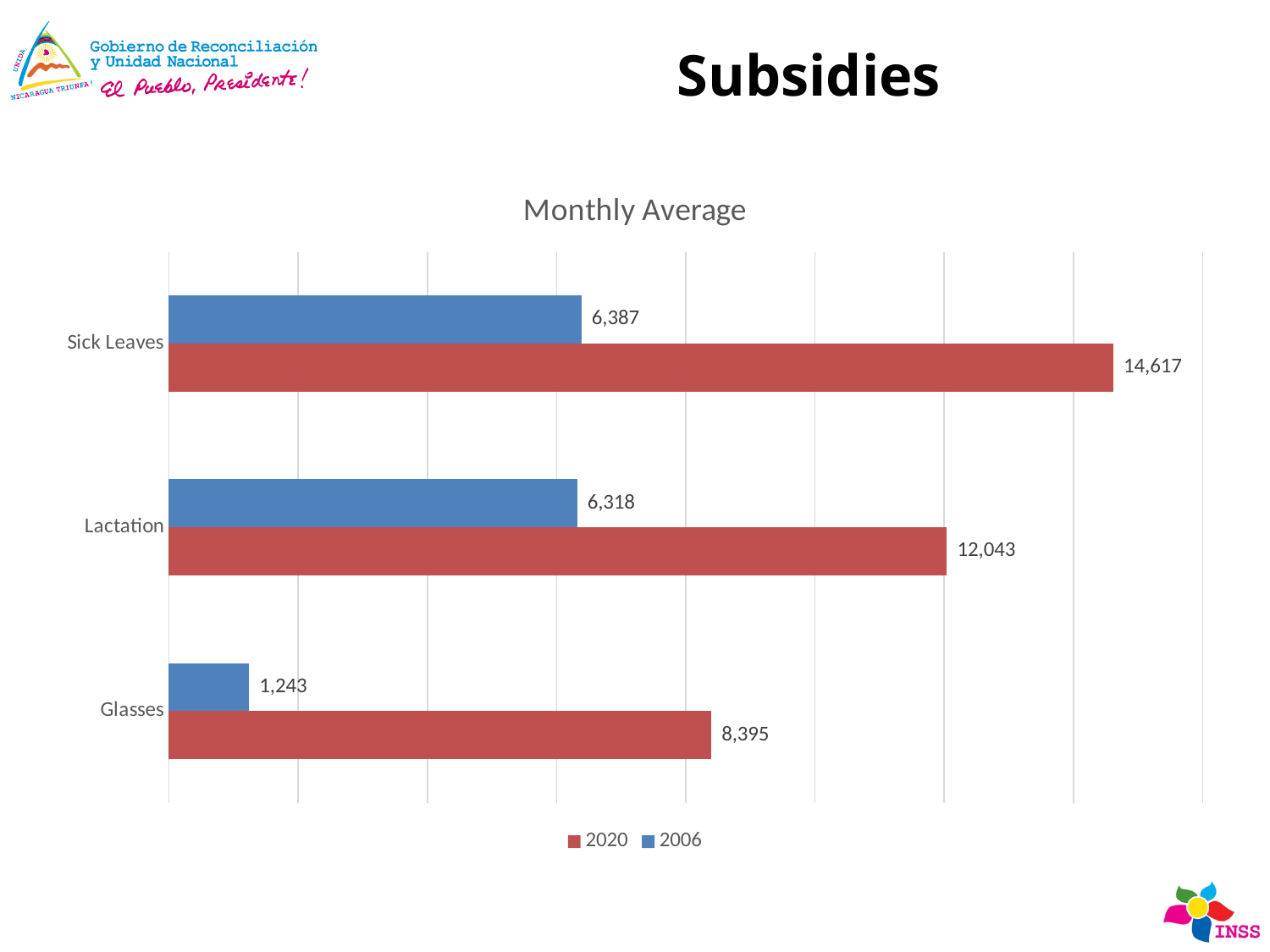
How many categories are shown on the chart? 3 What is the 2006 monthly average for Glasses? 1,243 What is the difference between the 2020 and 2006 values for Sick Leaves? 8,230 What is the 2006 monthly average for Lactation? 6,318 What is the 2020 monthly average for Sick Leaves? 14,617 Which category has the lowest 2006 value? Glasses What type of chart is shown? Bar chart What is the difference between the 2020 and 2006 values for Lactation? 5,725 How many series does the legend list? 2 What is the 2020 monthly average for Glasses? 8,395 Which is larger, the 2020 value for Glasses or the 2006 value for Sick Leaves? 2020 value for Glasses Which category has the highest 2020 value? Sick Leaves